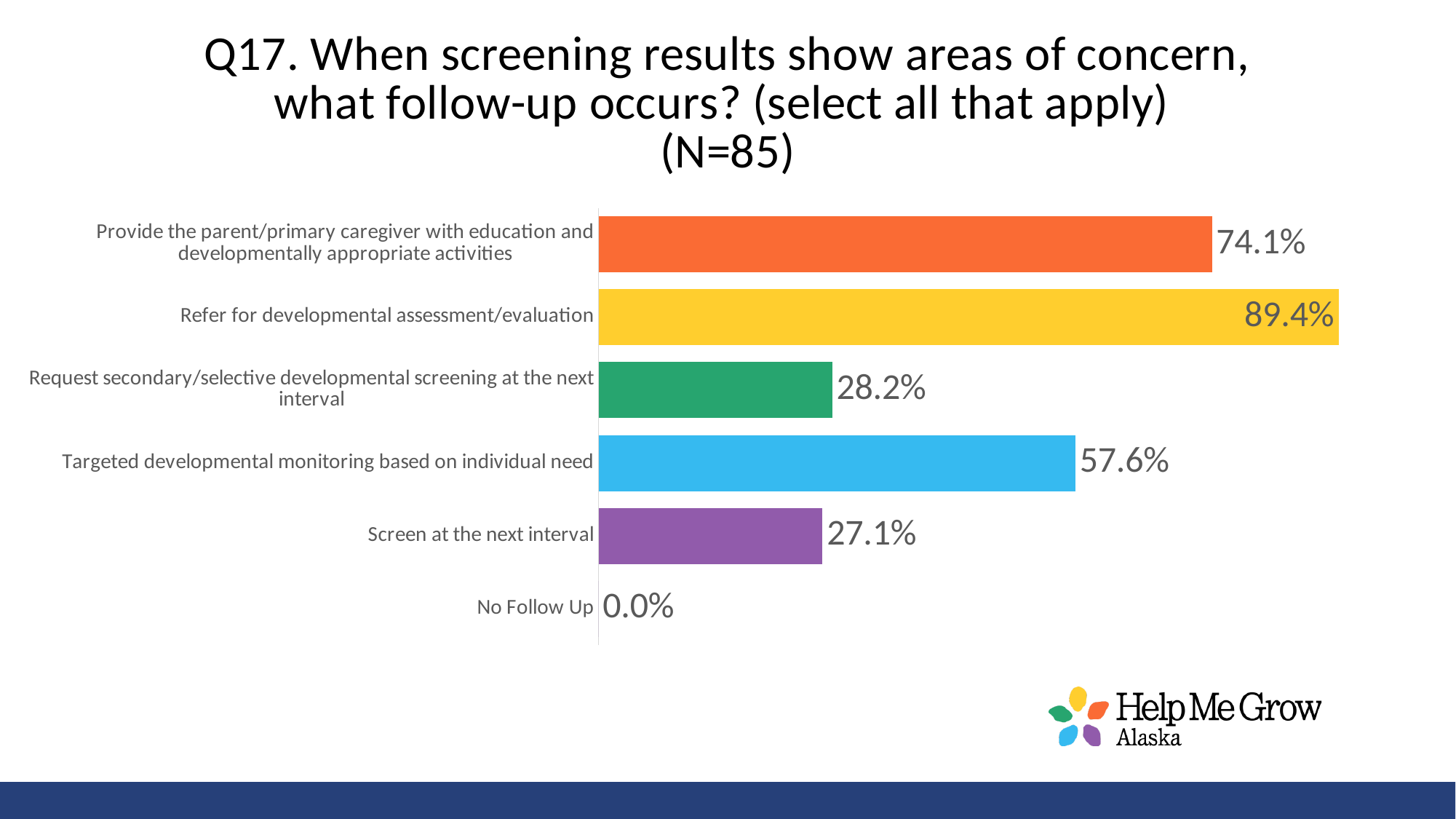
What kind of chart is shown on the slide? Bar chart How many follow-up categories are shown in the chart? 6 What percentage is shown for "Screen at the next interval"? 27.1% What is the sample size (N) stated in the chart title? 85 Which follow-up option has the highest percentage? Refer for developmental assessment/evaluation What is the value for "Targeted developmental monitoring based on individual need"? 57.6% What colour is the bar for "Refer for developmental assessment/evaluation"? Yellow What percentage of respondents selected "Refer for developmental assessment/evaluation"? 89.4% Which follow-up option has the lowest percentage? No Follow Up What is the value for "No Follow Up"? 0.0% Which is larger: the value for "Request secondary/selective developmental screening at the next interval" or the value for "Screen at the next interval"? Request secondary/selective developmental screening at the next interval What is the difference between the percentages for "Refer for developmental assessment/evaluation" and "Provide the parent/primary caregiver with education and developmentally appropriate activities"? 15.3%